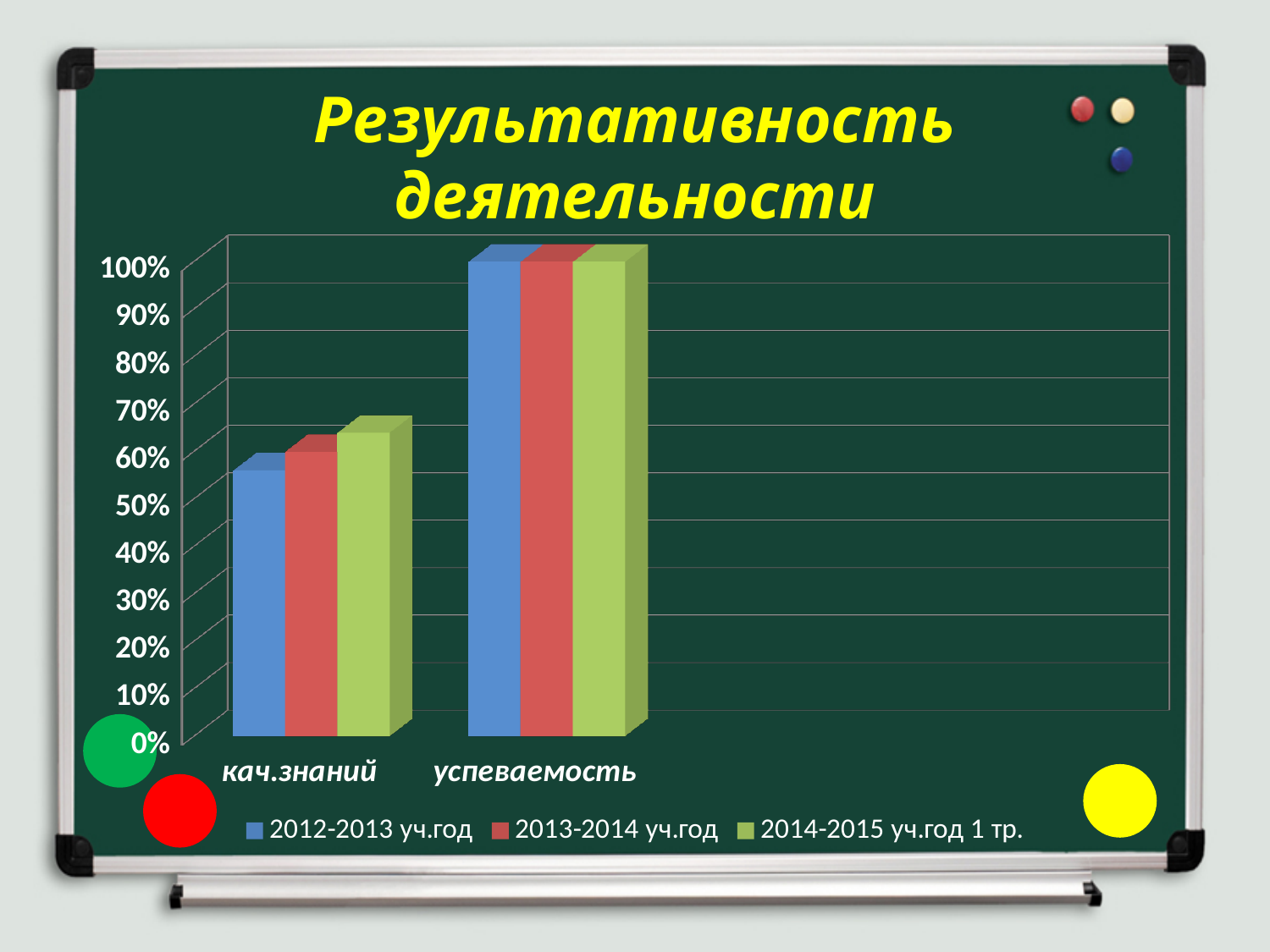
How many categories are shown on the x axis of the chart? 2 Is the value for кач.знаний in 2012-2013 уч.год greater or less than 50%? greater How many series does the chart's legend list? 3 What kind of chart is shown on the slide? bar chart Is the value for кач.знаний in 2014-2015 уч.год 1 тр. greater or less than 60%? greater For 2014-2015 уч.год 1 тр., which is larger: кач.знаний or успеваемость? успеваемость Which category has the highest value for 2013-2014 уч.год? успеваемость Is the value for кач.знаний in 2012-2013 уч.год greater or less than 70%? less Which series has the highest value for кач.знаний? 2014-2015 уч.год 1 тр. What colour represents the 2013-2014 уч.год series in the chart? red Do the values for кач.знаний rise or fall from 2012-2013 уч.год to 2014-2015 уч.год 1 тр.? rise